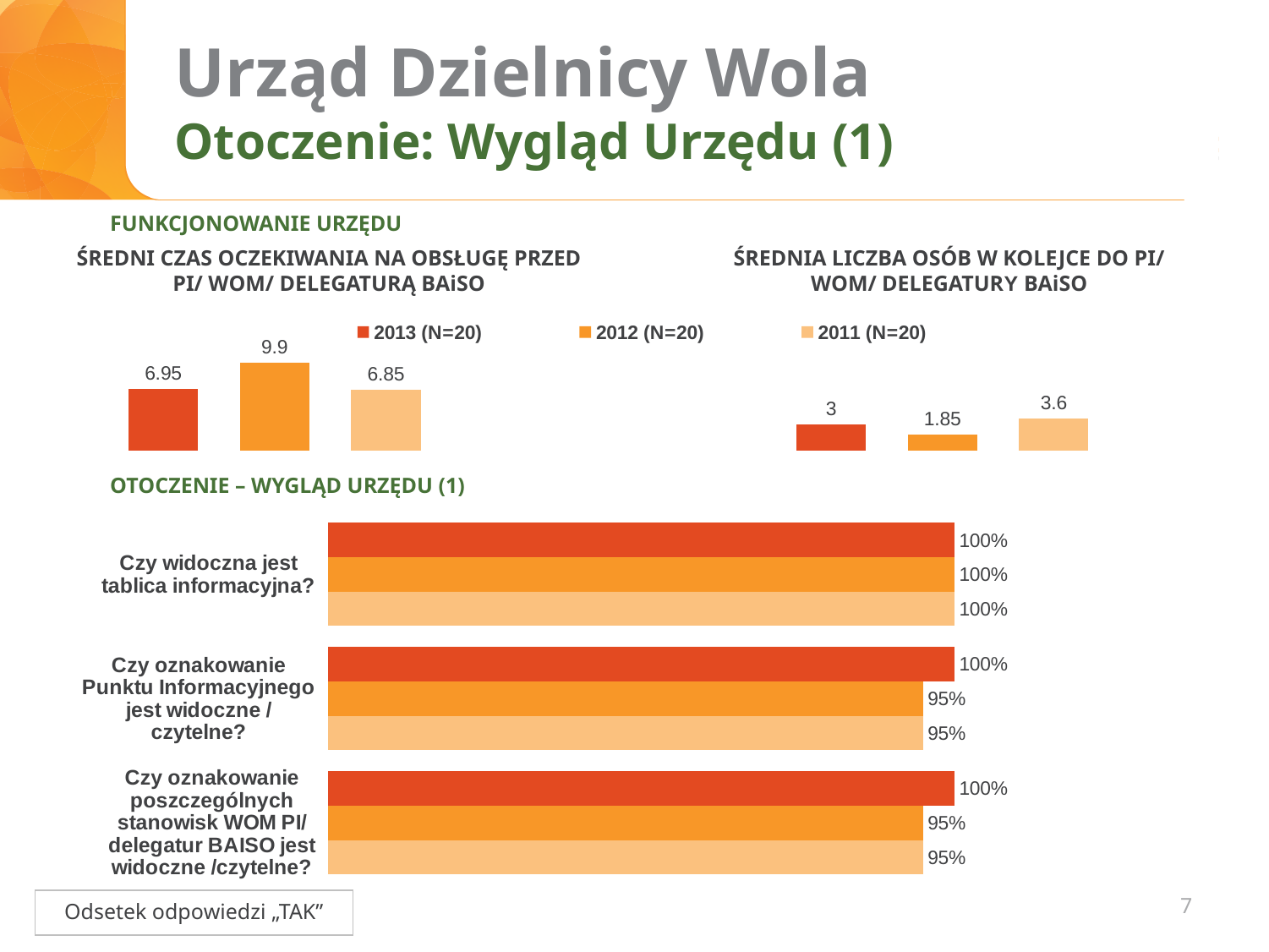
How many series does the legend list for the charts in the 'FUNKCJONOWANIE URZĘDU' section? 3 In the chart 'ŚREDNIA LICZBA OSÓB W KOLEJCE DO PI/ WOM/ DELEGATURY BAiSO', is the value for 2013 larger or smaller than the value for 2011? smaller In the chart 'ŚREDNI CZAS OCZEKIWANIA NA OBSŁUGĘ PRZED PI/ WOM/ DELEGATURĄ BAiSO', what is the value for 2012 (N=20)? 9.9 In the chart 'ŚREDNI CZAS OCZEKIWANIA NA OBSŁUGĘ PRZED PI/ WOM/ DELEGATURĄ BAiSO', which year has the lowest value? 2011 (N=20) In the chart 'ŚREDNI CZAS OCZEKIWANIA NA OBSŁUGĘ PRZED PI/ WOM/ DELEGATURĄ BAiSO', what is the difference between the 2012 and 2013 values? 2.95 In the chart 'ŚREDNIA LICZBA OSÓB W KOLEJCE DO PI/ WOM/ DELEGATURY BAiSO', what is the value for 2012 (N=20)? 1.85 How many question categories are shown in the chart 'OTOCZENIE – WYGLĄD URZĘDU (1)'? 3 In the chart 'OTOCZENIE – WYGLĄD URZĘDU (1)', what is the 2012 value for 'Czy oznakowanie Punktu Informacyjnego jest widoczne / czytelne?'? 95% In the chart 'OTOCZENIE – WYGLĄD URZĘDU (1)', what is the difference between the 2013 and 2011 values for 'Czy oznakowanie poszczególnych stanowisk WOM PI/ delegatur BAISO jest widoczne /czytelne?'? 5% What type of chart is 'OTOCZENIE – WYGLĄD URZĘDU (1)'? bar chart In the chart 'OTOCZENIE – WYGLĄD URZĘDU (1)', what is the 2011 value for 'Czy widoczna jest tablica informacyjna?'? 100% In the chart 'ŚREDNIA LICZBA OSÓB W KOLEJCE DO PI/ WOM/ DELEGATURY BAiSO', which year has the highest value? 2011 (N=20)